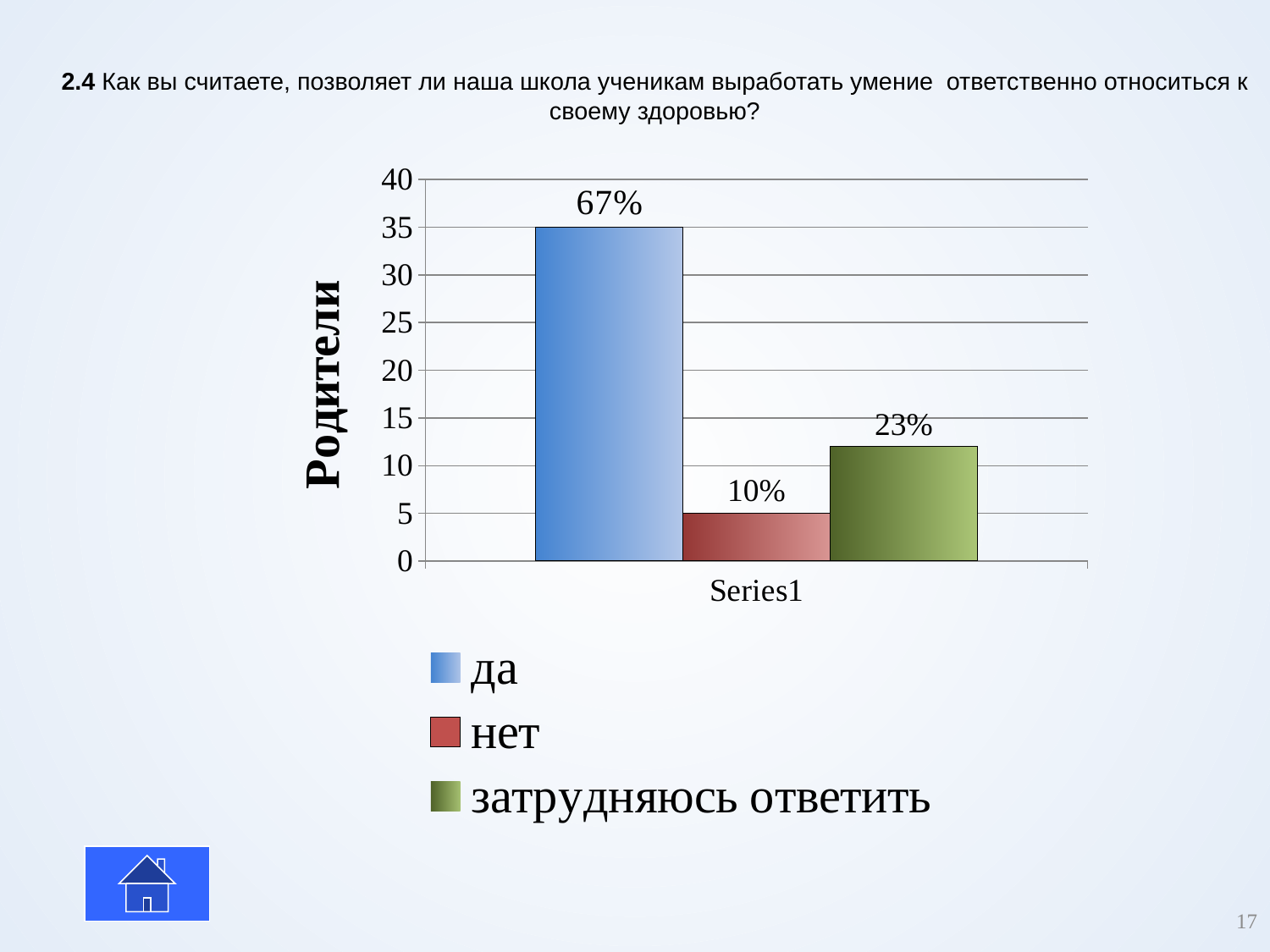
What is the label on the vertical axis of the chart? Родители Is the bar for "да" greater or less than 30 on the vertical axis? greater How many series does the legend list? 3 Which is larger, the value for "нет" or the value for "затрудняюсь ответить"? затрудняюсь ответить What data label is shown on the bar for "нет"? 10% Which answer option has the shortest bar? нет What kind of chart is shown on the slide? bar chart Is the bar for "затрудняюсь ответить" greater or less than 15 on the vertical axis? less What data label is shown on the bar for "да"? 67% What is the difference between the data labels for "да" and "нет"? 57% What data label is shown on the bar for "затрудняюсь ответить"? 23% Which answer option has the tallest bar? да